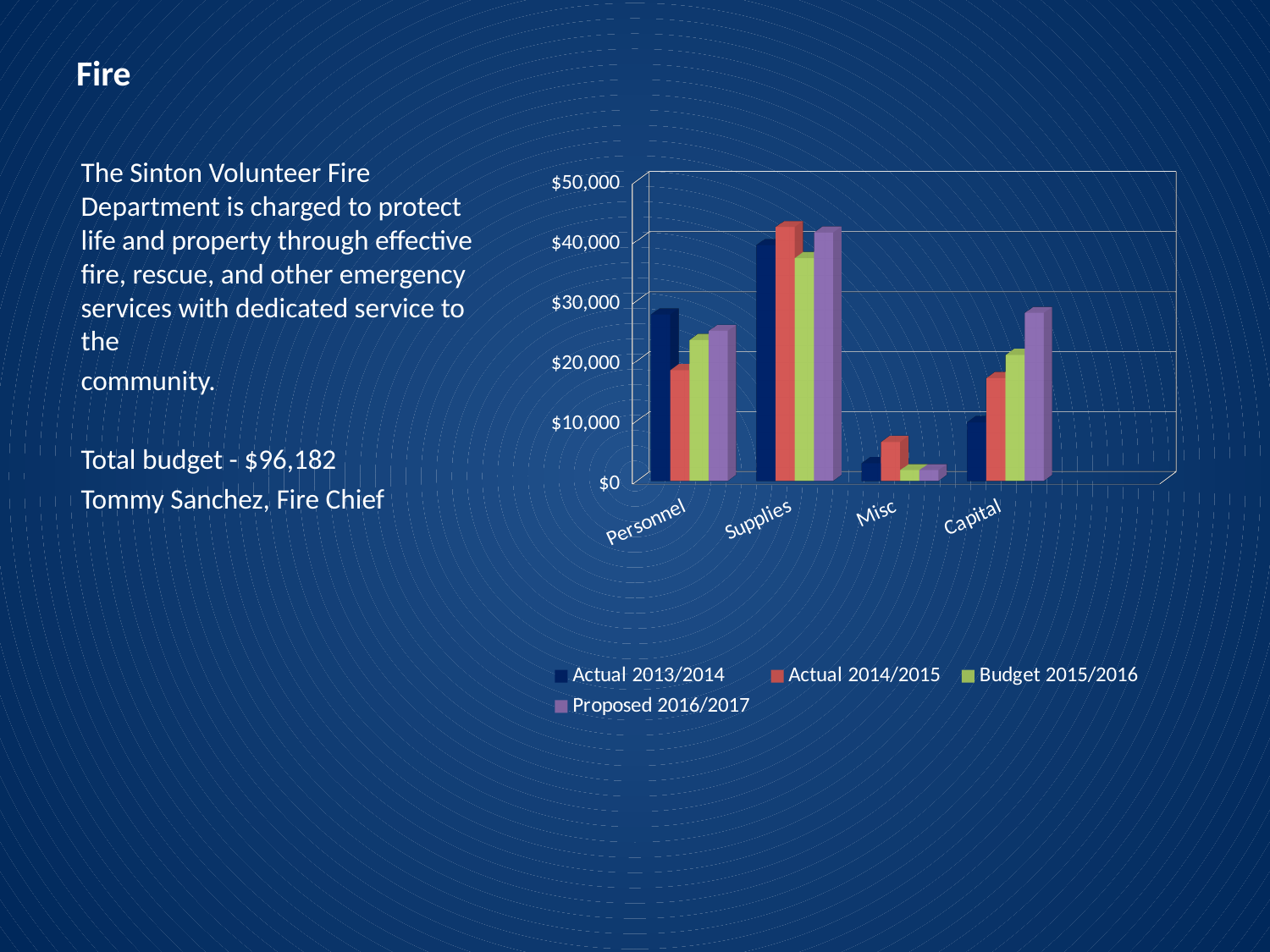
Which category has the lowest value for Proposed 2016/2017? Misc Is the value for Misc in Actual 2014/2015 greater or less than $10,000? less For Personnel, which is larger: Actual 2013/2014 or Actual 2014/2015? Actual 2013/2014 Is the value for Personnel in Actual 2014/2015 greater or less than $20,000? less What is the first series listed in the chart's legend? Actual 2013/2014 How many series does the chart's legend list? 4 What kind of chart is shown on the slide? bar chart Is the value for Supplies in Actual 2014/2015 greater or less than $40,000? greater How many categories are shown on the x axis of the chart? 4 Which category has the highest value for Actual 2014/2015? Supplies For Capital, which is larger: Budget 2015/2016 or Proposed 2016/2017? Proposed 2016/2017